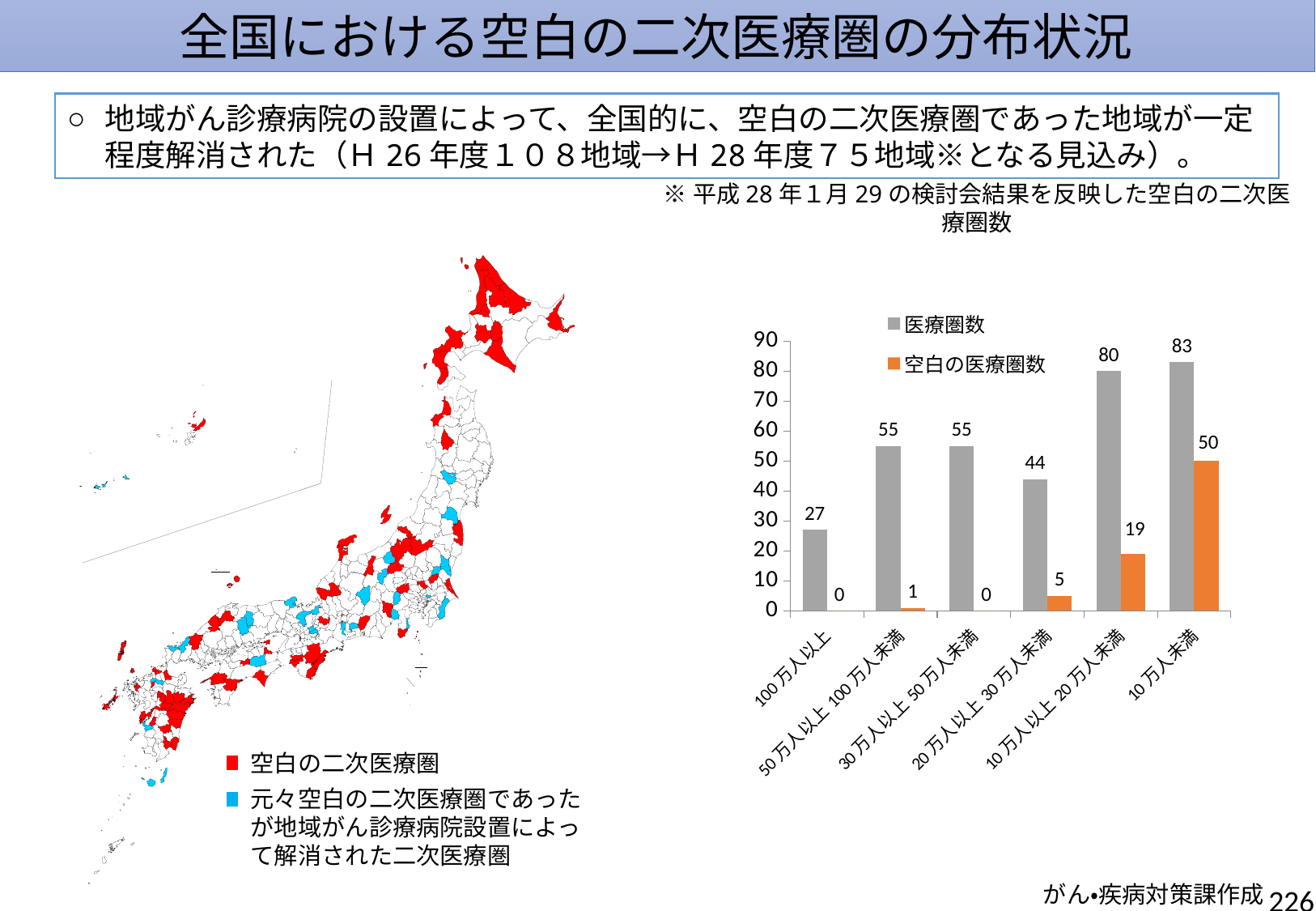
In the bar chart, what is the 空白の医療圏数 value for 10万人以上20万人未満? 19 In the bar chart, which category has the highest 医療圏数? 10万人未満 In the bar chart, which category has the lowest 医療圏数? 100万人以上 In the bar chart, is the 医療圏数 value for 100万人以上 greater or less than 30? less How many categories are shown on the x axis of the bar chart? 6 What kind of chart is shown on the right side of the slide? bar chart In the bar chart, which is larger: the 医療圏数 for 20万人以上30万人未満 or for 10万人以上20万人未満? 10万人以上20万人未満 In the bar chart, what colour are the 空白の医療圏数 bars? orange In the bar chart, what is the difference between 医療圏数 and 空白の医療圏数 for 10万人未満? 33 In the bar chart, what is the 空白の医療圏数 value for 50万人以上100万人未満? 1 In the bar chart, what is the 医療圏数 value for 10万人未満? 83 How many series does the legend of the bar chart list? 2